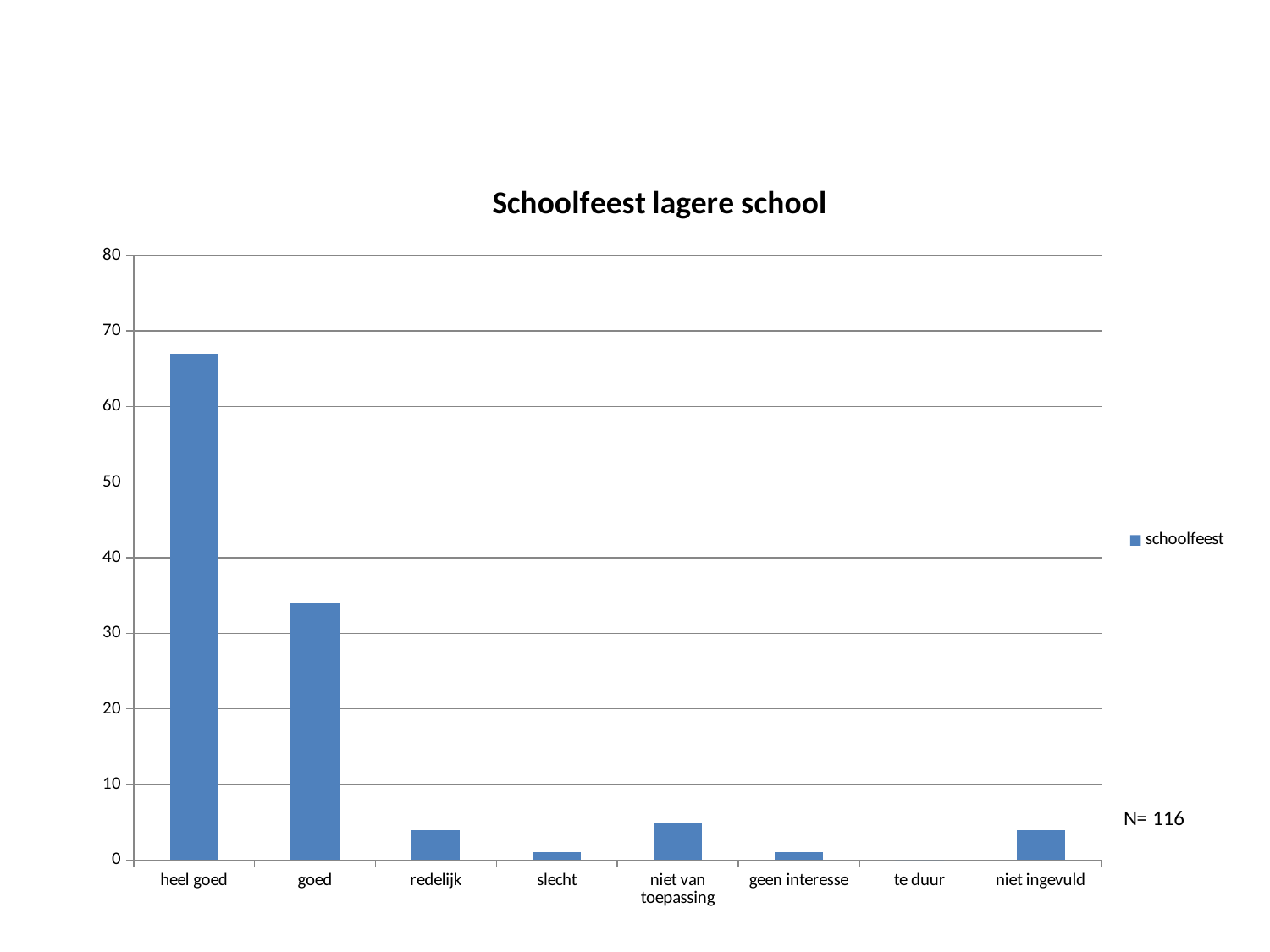
How many categories are shown on the x axis of the chart? 8 What is the title of the chart? Schoolfeest lagere school What is the name of the series shown in the legend? schoolfeest Which category has the lowest value? te duur What type of chart is shown on the slide? bar chart Is the value for niet van toepassing greater or less than 10? less Is the value for goed greater or less than 40? less Is the value for heel goed greater or less than 60? greater Which is larger, the value for heel goed or the value for goed? heel goed Which category has the highest value? heel goed How many series does the legend list? 1 Which is larger, the value for niet van toepassing or the value for slecht? niet van toepassing